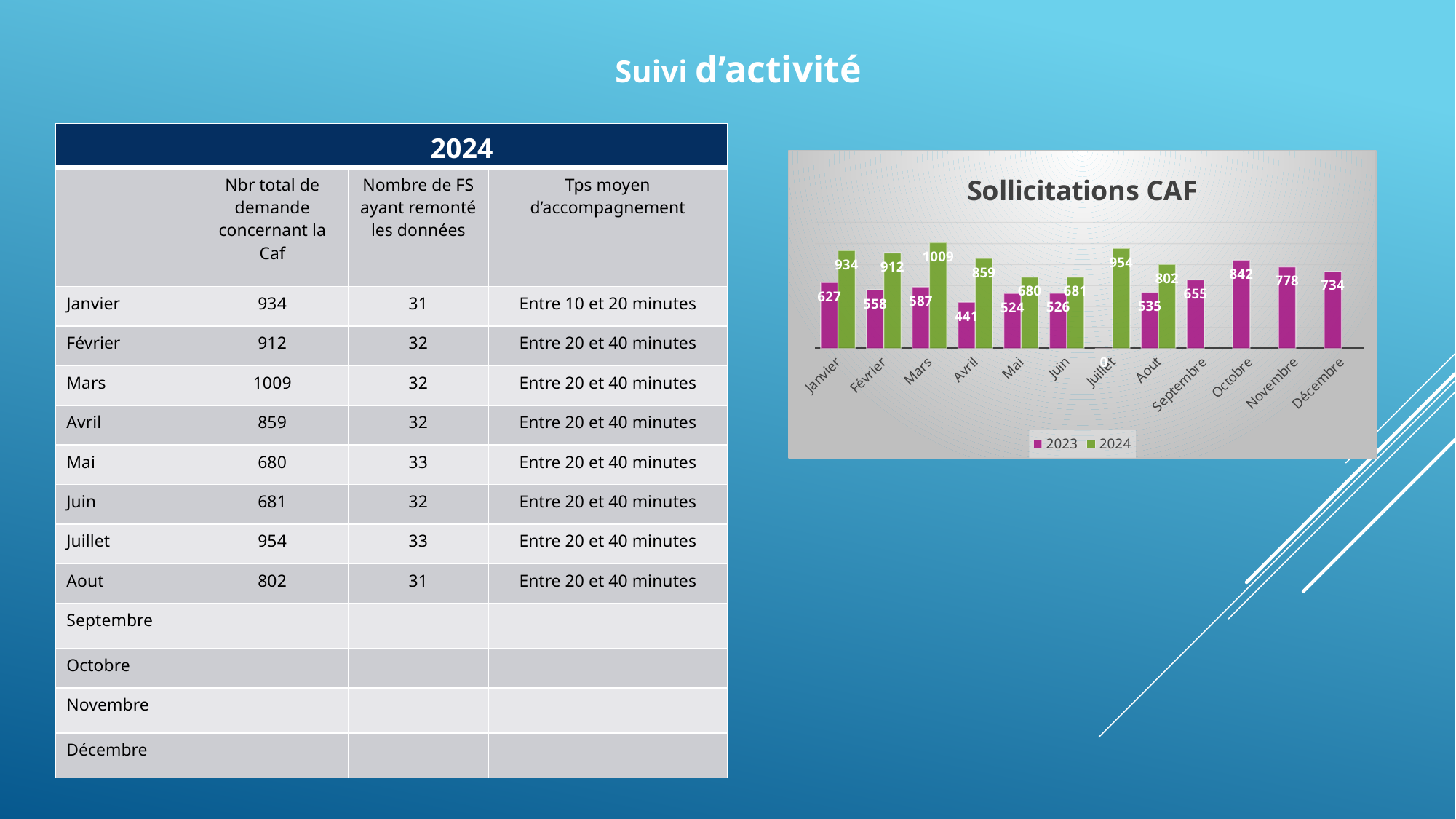
What is the 2024 value for Mars in the chart? 1009 What is the 2023 value for Avril in the chart? 441 How many series does the chart legend list? 2 Which colour represents the 2024 series in the chart? green Which month has the highest 2024 value in the chart? Mars Which is larger for Mai: the 2023 value or the 2024 value? 2024 What is the title of the chart? Sollicitations CAF What is the 2023 value for Octobre in the chart? 842 What kind of chart is shown on the slide? bar chart Which month has the lowest 2023 value in the chart? Juillet How many months are shown on the x axis of the chart? 12 What is the difference between the 2024 and 2023 values for Janvier? 307